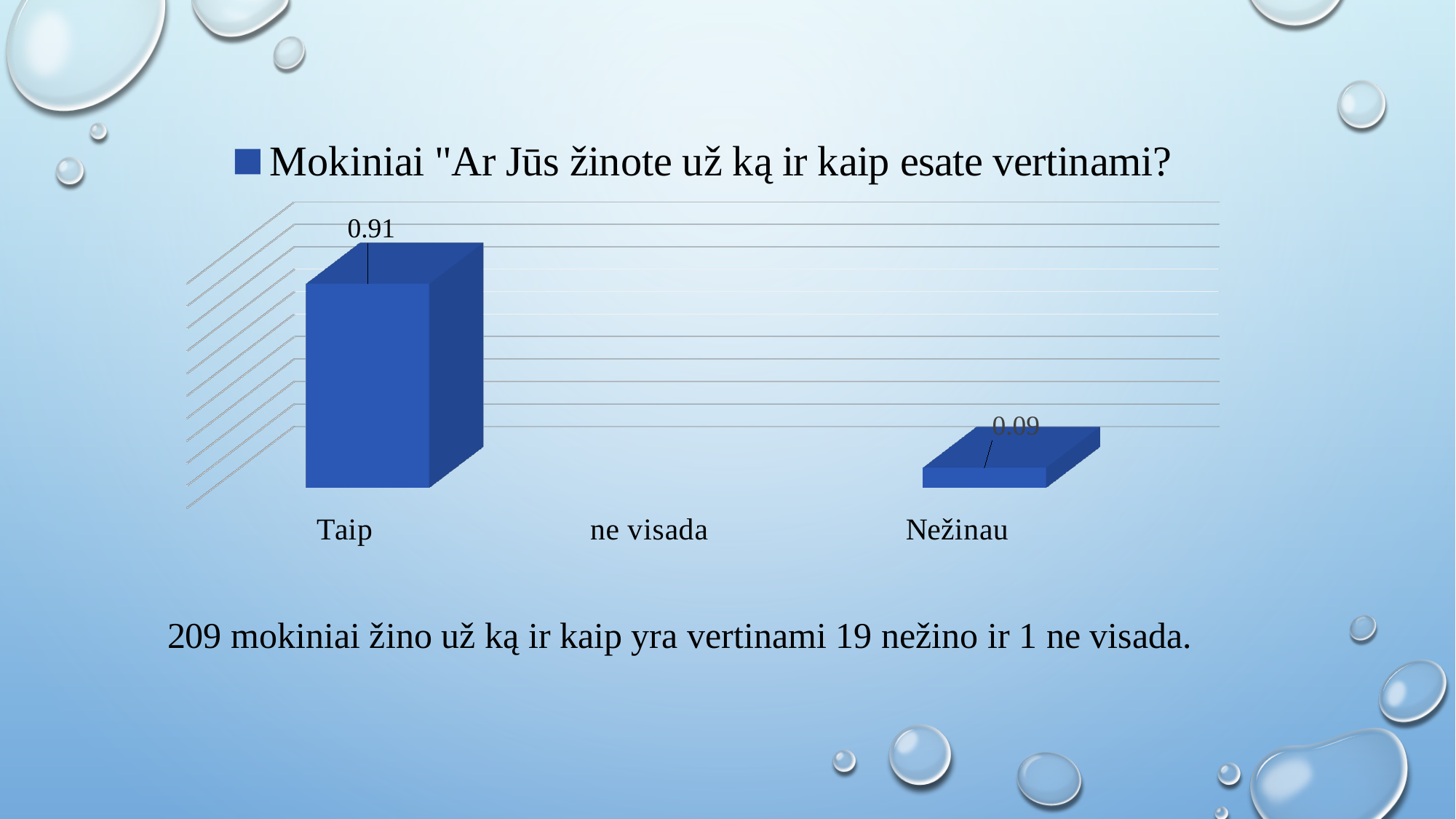
How many categories are shown on the x axis? 3 How many series does the legend list? 1 What is the value for Taip? 0.91 Which category is the middle one on the x axis? ne visada What is the value for Nežinau? 0.09 What kind of chart is shown on the slide? Bar chart What is the difference between the values for Taip and Nežinau? 0.82 What colour are the bars in the chart? Blue What is the legend entry for the series? Mokiniai "Ar Jūs žinote už ką ir kaip esate vertinami? Which is larger, the value for Taip or the value for Nežinau? Taip Which category has the highest value? Taip